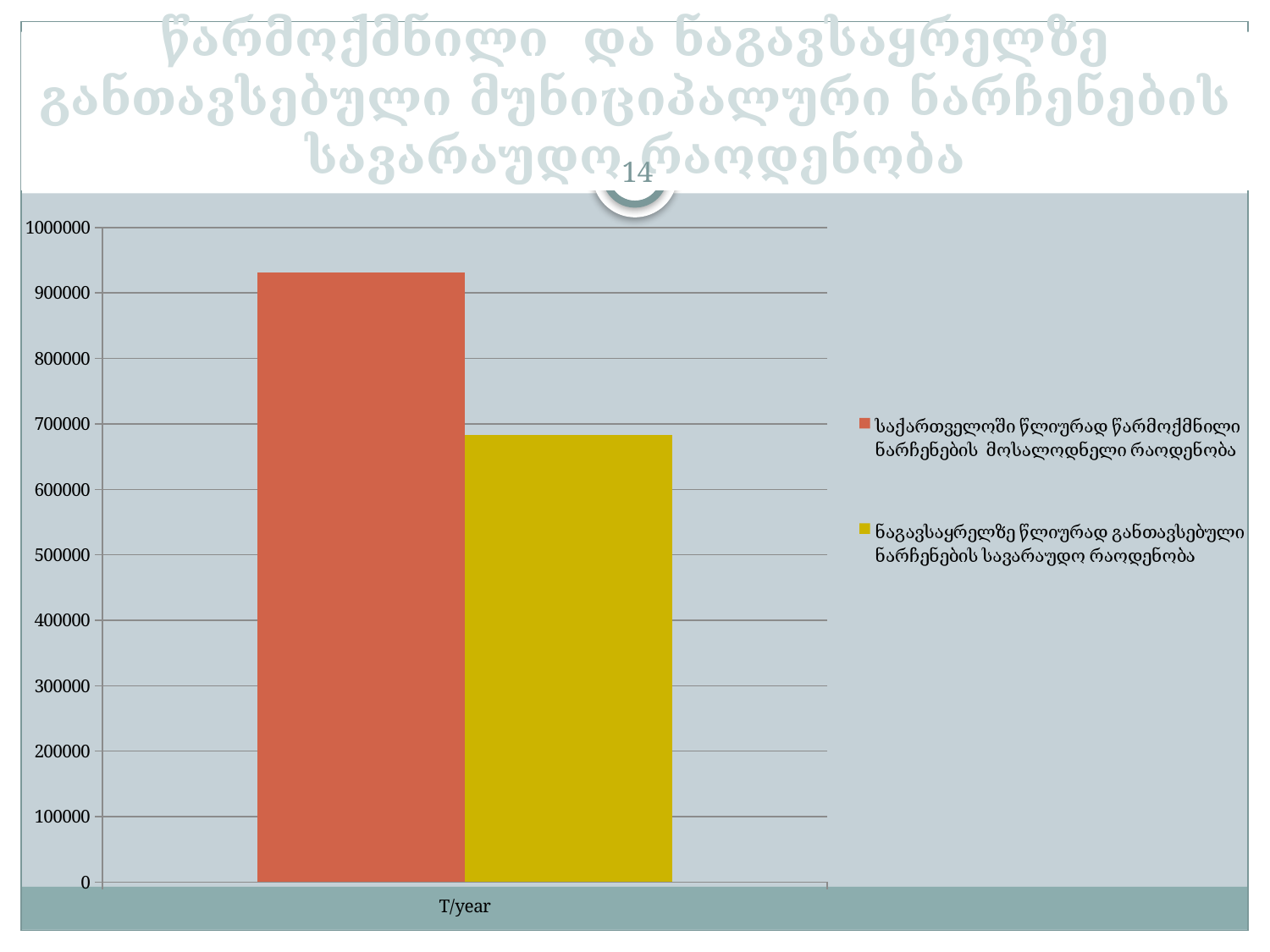
Which series has the higher bar: საქართველოში წლიურად წარმოქმნილი ნარჩენების მოსალოდნელი რაოდენობა or ნაგავსაყრელზე წლიურად განთავსებული ნარჩენების სავარაუდო რაოდენობა? საქართველოში წლიურად წარმოქმნილი ნარჩენების მოსალოდნელი რაოდენობა How many categories are shown on the x axis? 1 Which series has the lowest bar? ნაგავსაყრელზე წლიურად განთავსებული ნარჩენების სავარაუდო რაოდენობა What colour is the bar for ნაგავსაყრელზე წლიურად განთავსებული ნარჩენების სავარაუდო რაოდენობა? yellow Is the value for საქართველოში წლიურად წარმოქმნილი ნარჩენების მოსალოდნელი რაოდენობა greater or less than 900000? greater Is the value for ნაგავსაყრელზე წლიურად განთავსებული ნარჩენების სავარაუდო რაოდენობა greater or less than 700000? less What is the category label shown on the x axis? T/year Is the value for ნაგავსაყრელზე წლიურად განთავსებული ნარჩენების სავარაუდო რაოდენობა greater or less than 600000? greater How many series does the legend list? 2 Which series has the highest bar? საქართველოში წლიურად წარმოქმნილი ნარჩენების მოსალოდნელი რაოდენობა What kind of chart is shown on the slide? bar chart